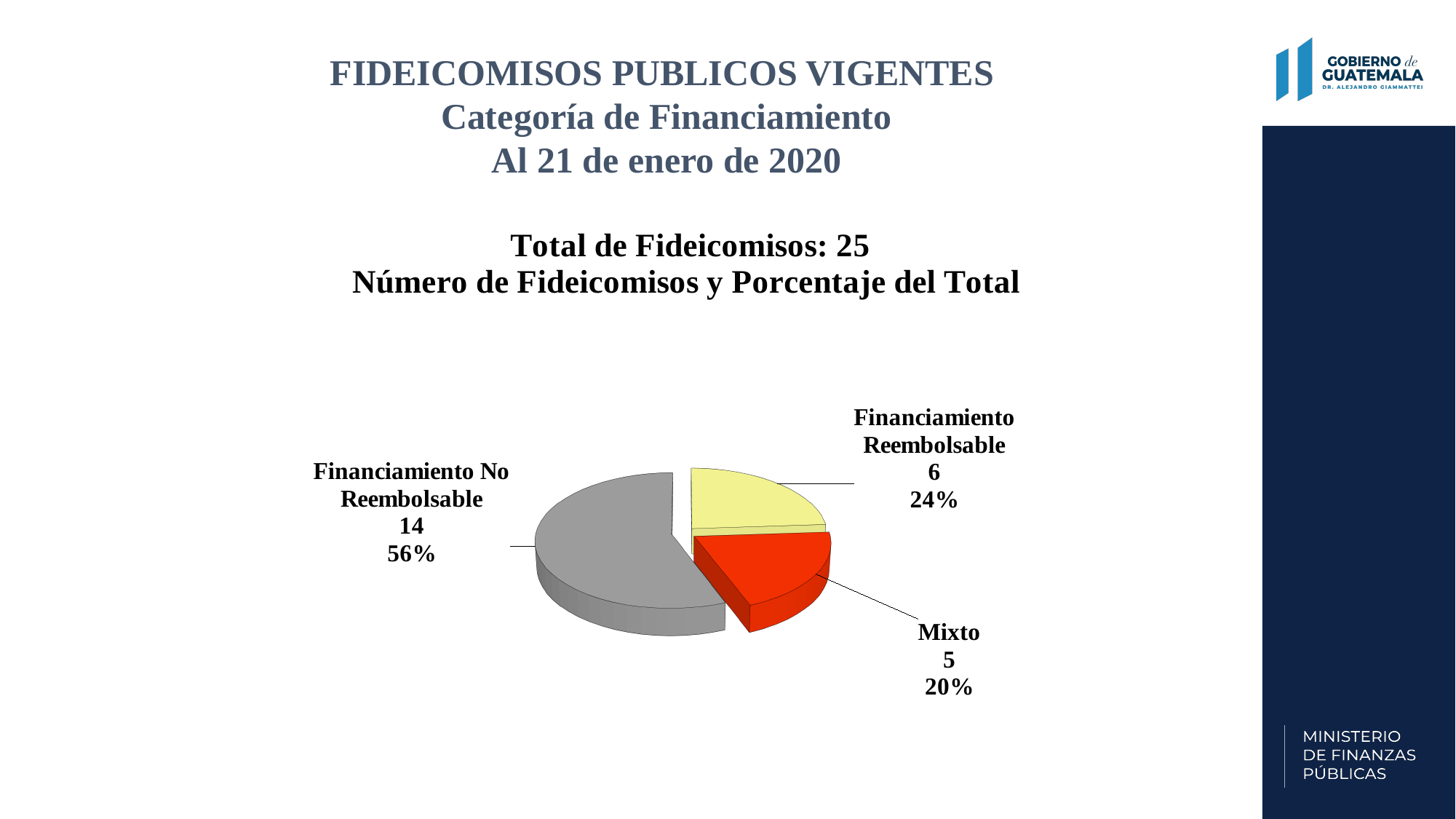
How many fideicomisos are in the Financiamiento No Reembolsable category? 14 Which has more fideicomisos, Financiamiento Reembolsable or Mixto? Financiamiento Reembolsable What colour is the Mixto slice of the pie chart? Red Which category has the smallest number of fideicomisos? Mixto How many categories are shown in the pie chart? 3 What percentage of the total does the Mixto slice represent? 20% What percentage of the total does Financiamiento Reembolsable represent? 24% What is the total number of fideicomisos stated on the slide? 25 Which category has the largest number of fideicomisos? Financiamiento No Reembolsable What is the difference in the number of fideicomisos between Financiamiento No Reembolsable and Financiamiento Reembolsable? 8 What type of chart is shown on the slide? Pie chart How many fideicomisos are in the Mixto category? 5